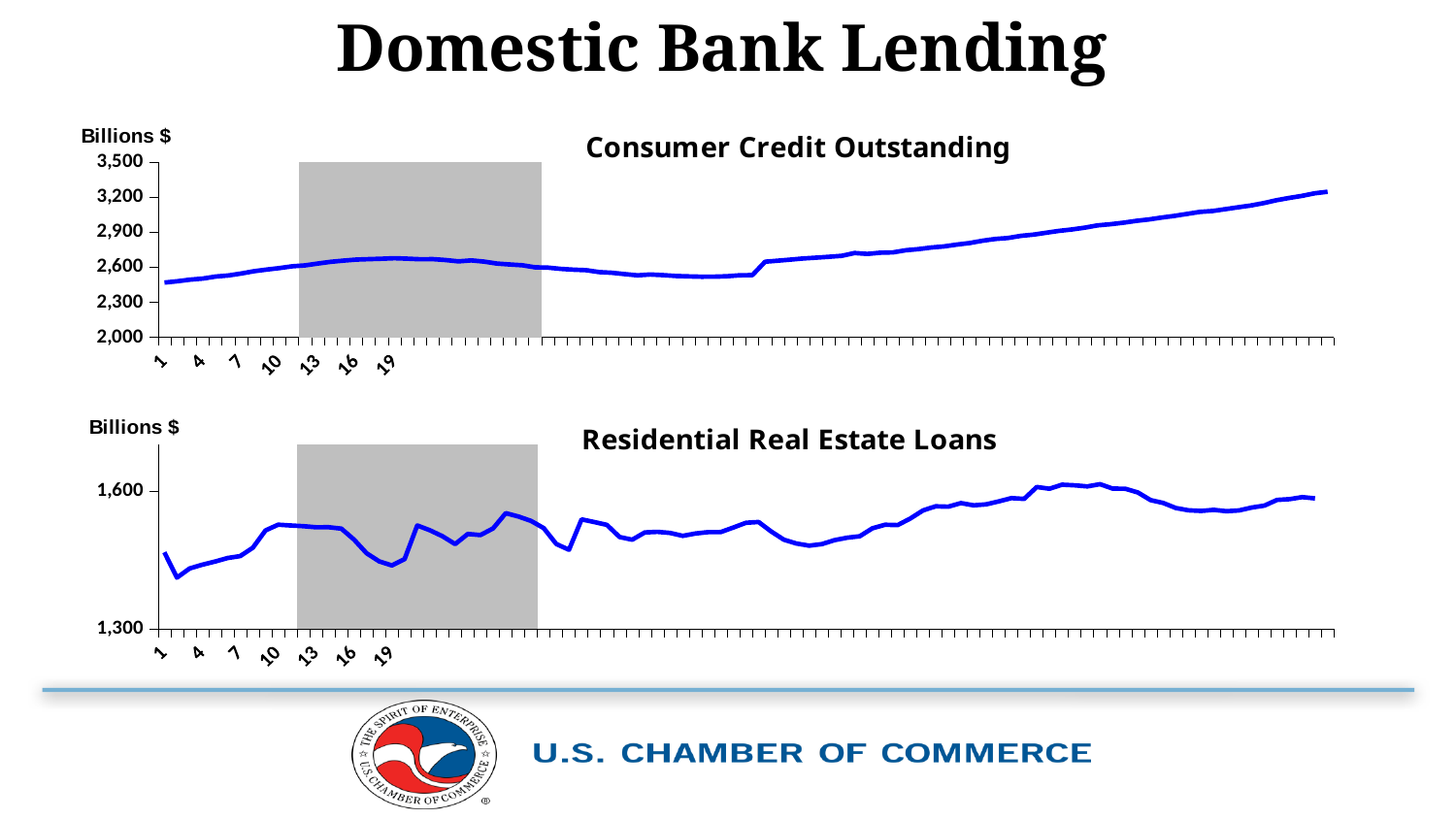
In the Residential Real Estate Loans chart, is the value at point 1 greater or less than 1,600? less In the Consumer Credit Outstanding chart, is the value at point 1 greater or less than 2,300? greater What kind of chart is the Consumer Credit Outstanding chart? line chart In the Consumer Credit Outstanding chart, does the line generally rise or fall from the shaded region to the right end of the chart? rise In the Consumer Credit Outstanding chart, is the value at point 16 greater or less than 2,900? less In the Consumer Credit Outstanding chart, is the value at the far right end of the line higher or lower than the value at point 1? higher What is the title of the lower chart on the slide? Residential Real Estate Loans What kind of chart is the Residential Real Estate Loans chart? line chart What unit is shown on the y axis of both charts? Billions $